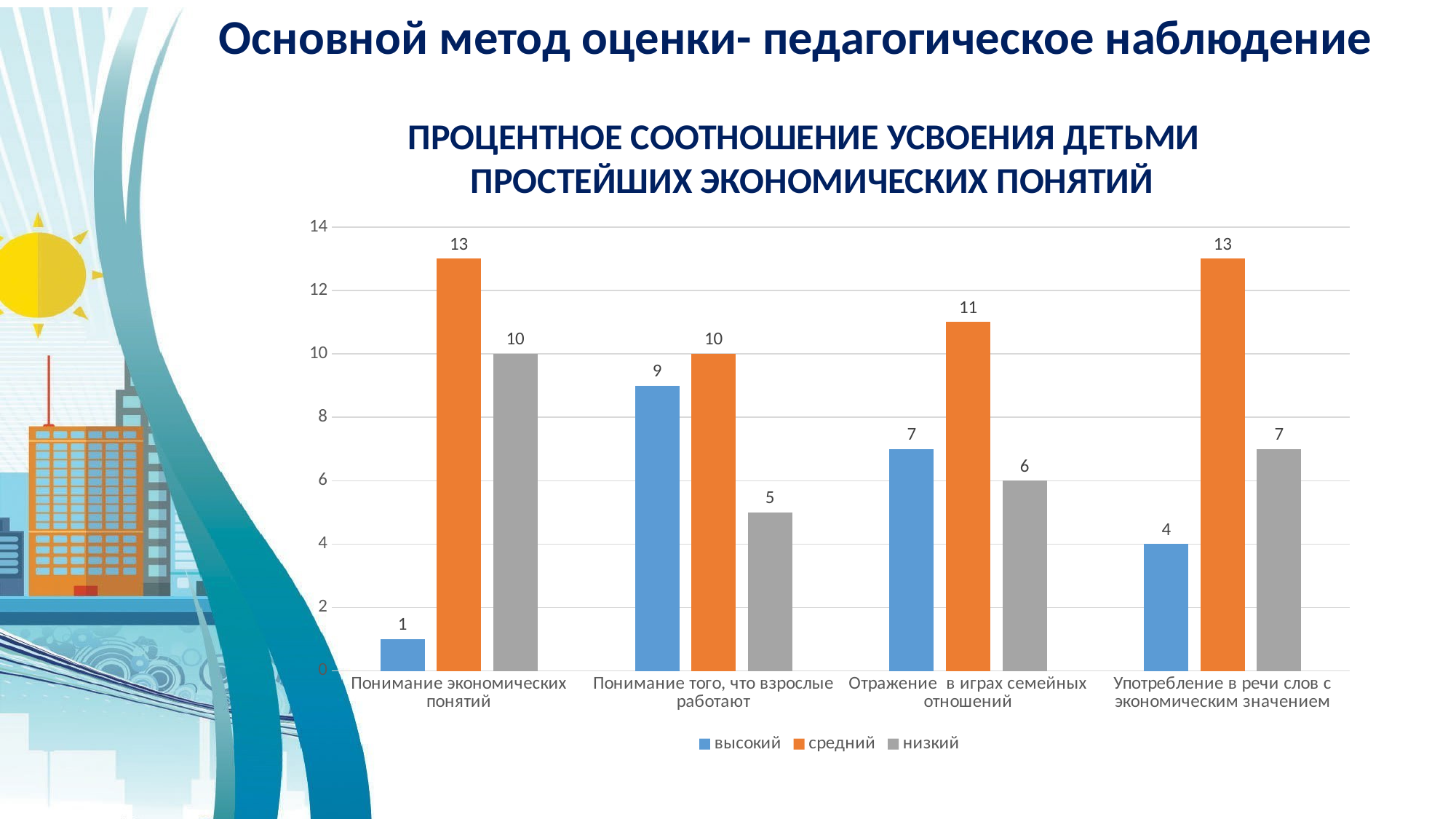
What is the title of the chart? ПРОЦЕНТНОЕ СООТНОШЕНИЕ УСВОЕНИЯ ДЕТЬМИ ПРОСТЕЙШИХ ЭКОНОМИЧЕСКИХ ПОНЯТИЙ How many categories are shown on the x axis? 4 Which is larger: the 'низкий' value for 'Понимание экономических понятий' or the 'низкий' value for 'Отражение в играх семейных отношений'? Понимание экономических понятий What is the value of the 'низкий' series for 'Понимание того, что взрослые работают'? 5 How many series does the legend list? 3 Which colour represents the 'средний' series? Orange Which category has the lowest value in the 'низкий' series? Понимание того, что взрослые работают What is the difference between the 'средний' and 'высокий' values for 'Употребление в речи слов с экономическим значением'? 9 Which category has the highest value in the 'высокий' series? Понимание того, что взрослые работают What is the value of the 'высокий' series for 'Понимание экономических понятий'? 1 What is the value of the 'средний' series for 'Отражение в играх семейных отношений'? 11 What kind of chart is shown on the slide? Bar chart